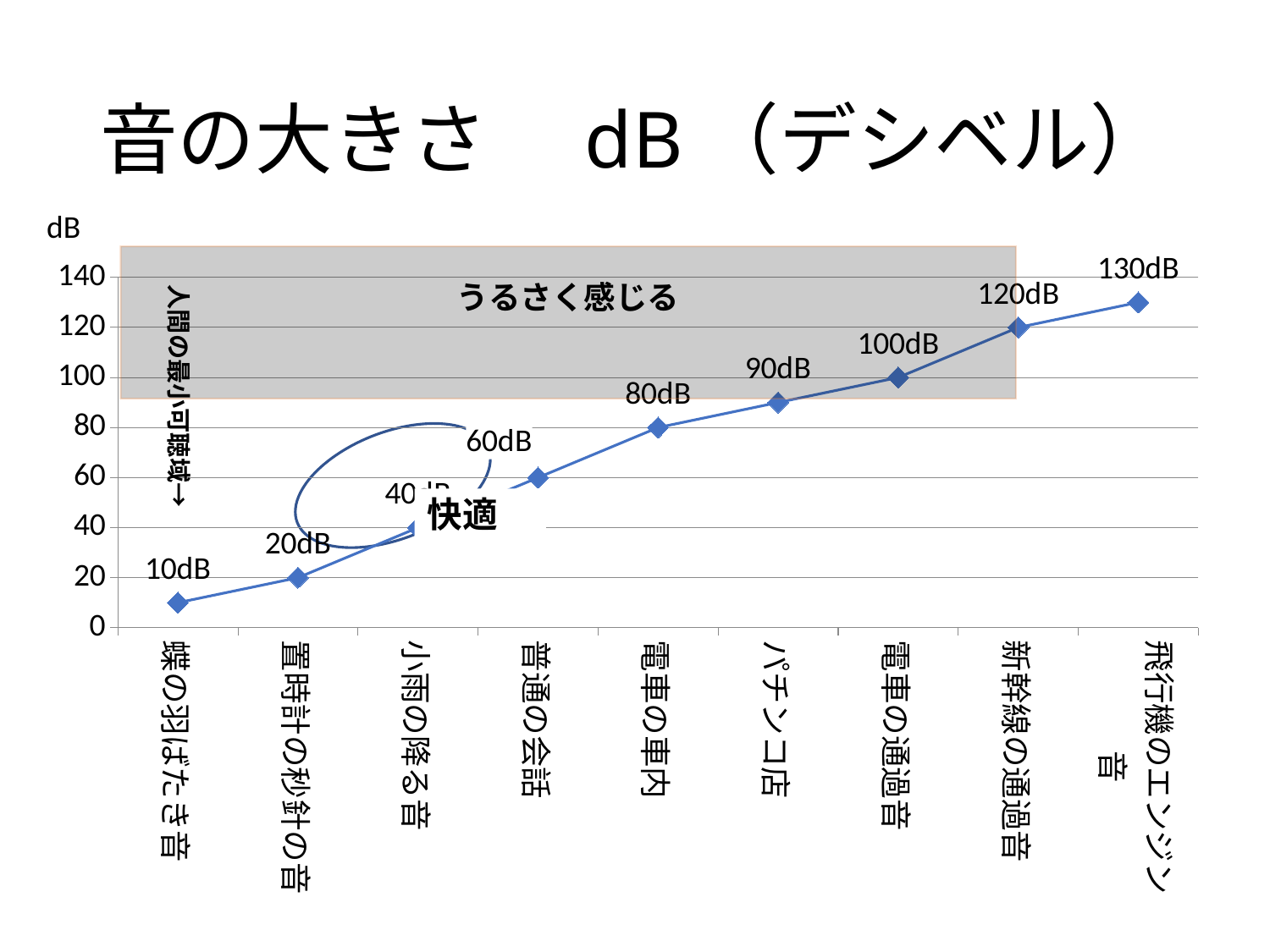
Do the values rise or fall from left to right along the x axis? rise What is the value for パチンコ店? 90dB What kind of chart is shown on the slide? line chart What is the value for 電車の車内? 80dB Is the value for 小雨の降る音 greater or less than 60? less Which is larger, the value for 電車の通過音 or the value for 電車の車内? 電車の通過音 What is the value for 新幹線の通過音? 120dB What is the value for 普通の会話? 60dB How many categories are plotted on the x axis? 9 Which category has the lowest value? 蝶の羽ばたき音 Which category has the highest value? 飛行機のエンジン音 What is the difference between the values for 飛行機のエンジン音 and 普通の会話? 70dB